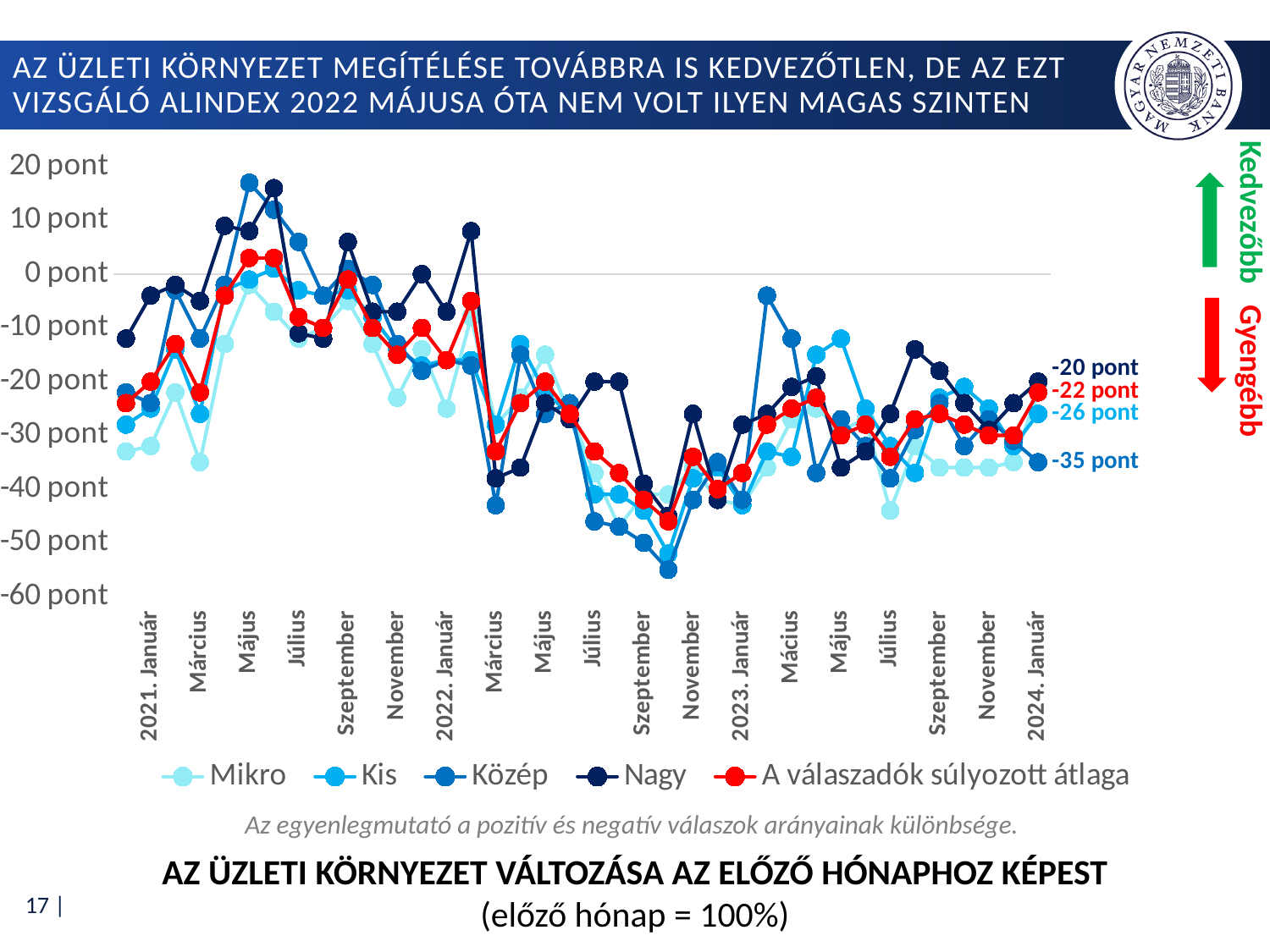
What is the value of the Kis series at 2024. Január? -26 pont At 2024. Január, which is higher: the Nagy series or the Közép series? Nagy What is the value of the Közép series at 2024. Január? -35 pont What is the value of 'A válaszadók súlyozott átlaga' at 2024. Január? -22 pont What kind of chart is shown on the slide? line chart What is the value of the Nagy series at 2024. Január? -20 pont What colour is the line for 'A válaszadók súlyozott átlaga' in the legend? red What is the difference between the Nagy value and the Közép value at 2024. Január? 15 pont Is the value of the Közép series at 2021 Május greater or less than 10 pont? greater Which series has the highest value at 2024. Január? Nagy Is the value of the Nagy series at 2022 Március greater or less than -30 pont? less How many series does the legend list? 5